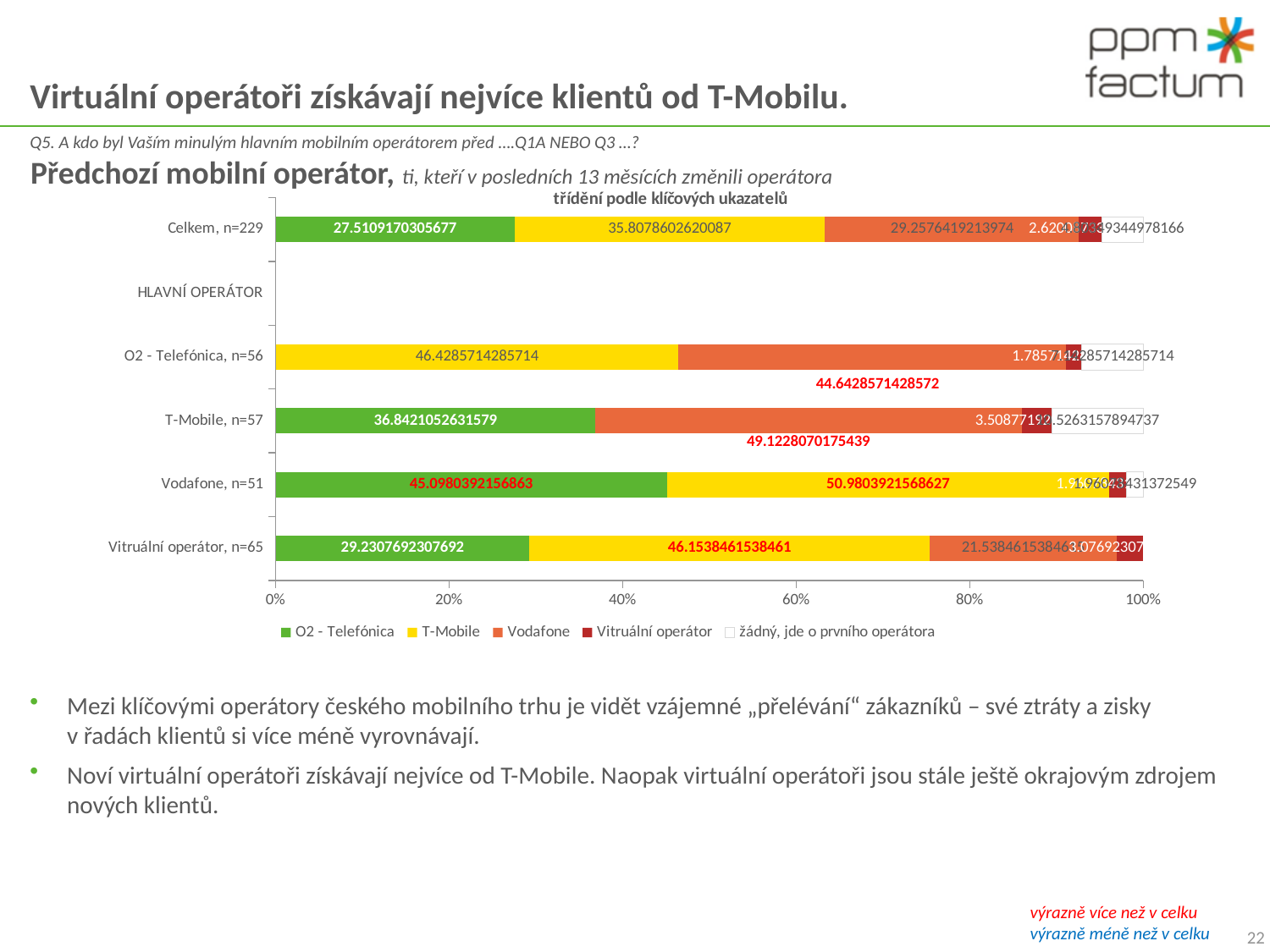
What is the last entry in the chart legend? žádný, jde o prvního operátora In the 'Celkem, n=229' bar, what is the difference between the T-Mobile value and the O2 - Telefónica value? 8.296943231441 In the 'Celkem, n=229' bar, what is the value for O2 - Telefónica? 27.5109170305677 In the 'T-Mobile, n=57' bar, what is the value for Vodafone? 49.1228070175439 In the 'Vitruální operátor, n=65' bar, what is the value for O2 - Telefónica? 29.2307692307692 In the 'O2 - Telefónica, n=56' bar, what is the value for T-Mobile? 46.4285714285714 How many series does the chart legend list? 5 In the 'Celkem, n=229' bar, which is larger: the T-Mobile segment or the O2 - Telefónica segment? T-Mobile What kind of chart is shown on the slide? Stacked bar chart In the 'T-Mobile, n=57' bar, what is the value for O2 - Telefónica? 36.8421052631579 In the 'Celkem, n=229' bar, what is the value for T-Mobile? 35.8078602620087 In the 'Vodafone, n=51' bar, what is the value for T-Mobile? 50.9803921568627